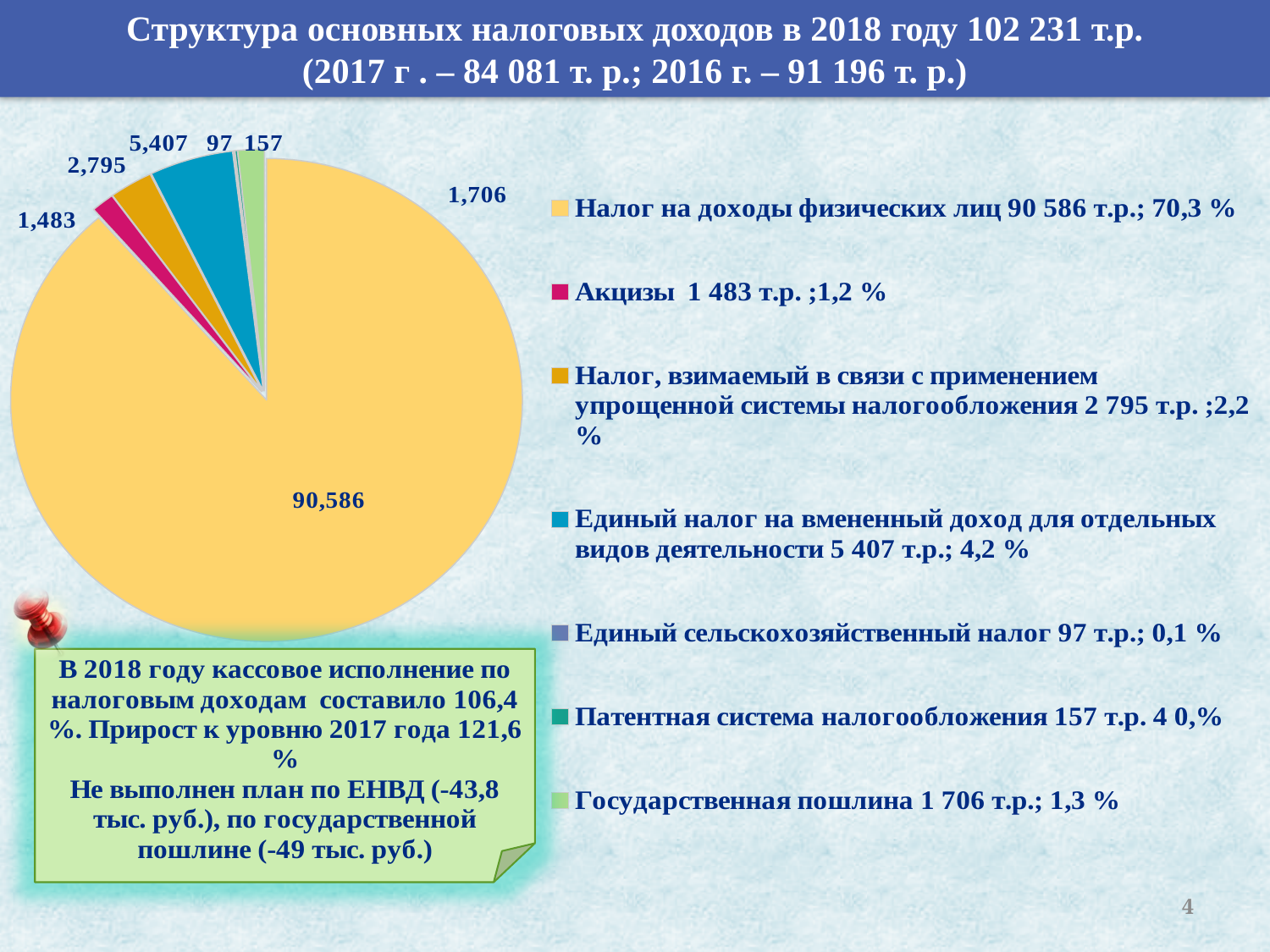
What is the value shown for Акцизы? 1,483 How many slices does the pie chart have? 7 Which category has the smallest slice of the pie? Единый сельскохозяйственный налог What is the value shown for Единый налог на вмененный доход для отдельных видов деятельности? 5,407 What is the value shown for Налог на доходы физических лиц? 90,586 What is the difference between the values for Единый налог на вмененный доход and Налог, взимаемый в связи с применением упрощенной системы налогообложения? 2,612 What kind of chart is shown on the slide? pie chart Which category has the largest slice of the pie? Налог на доходы физических лиц Which is larger: the value for Государственная пошлина or the value for Акцизы? Государственная пошлина What colour is the slice for Акцизы in the pie chart? magenta (pink-red) What is the value shown for Патентная система налогообложения? 157 According to the legend, what share of the pie does Налог на доходы физических лиц represent? 70,3 %